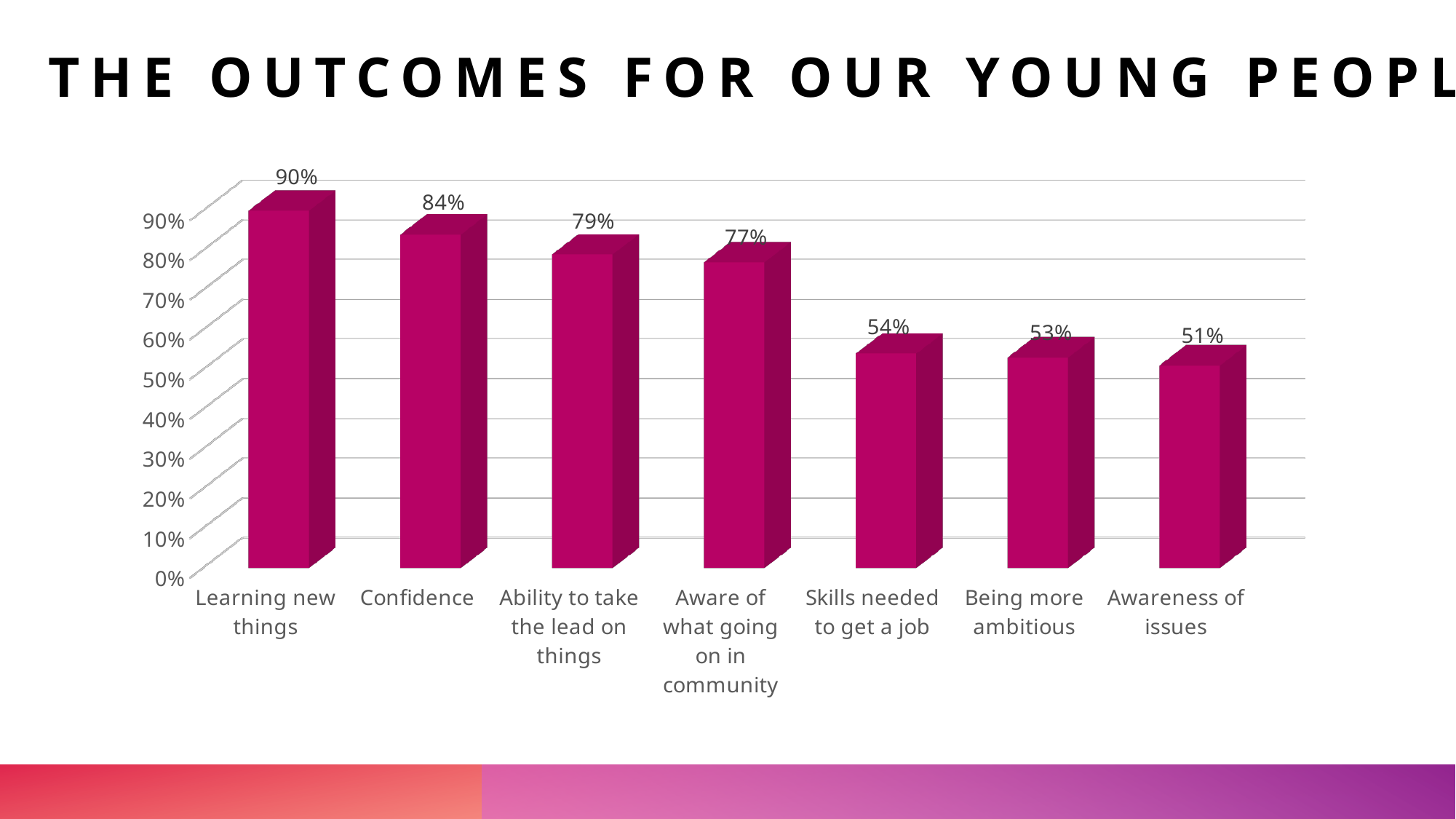
What is the value for Skills needed to get a job? 54% What kind of chart is shown on the slide? bar chart Is the value for Ability to take the lead on things greater or less than 70%? greater Which is larger, the value for Confidence or the value for Being more ambitious? Confidence What is the difference between the values for Ability to take the lead on things and Awareness of issues? 28% What is the difference between the values for Learning new things and Confidence? 6% Which category has the highest value? Learning new things What is the value for Confidence? 84% What is the value for Aware of what going on in community? 77% How many categories are shown on the chart? 7 Which category has the lowest value? Awareness of issues Do the values rise or fall from left to right along the x axis? fall